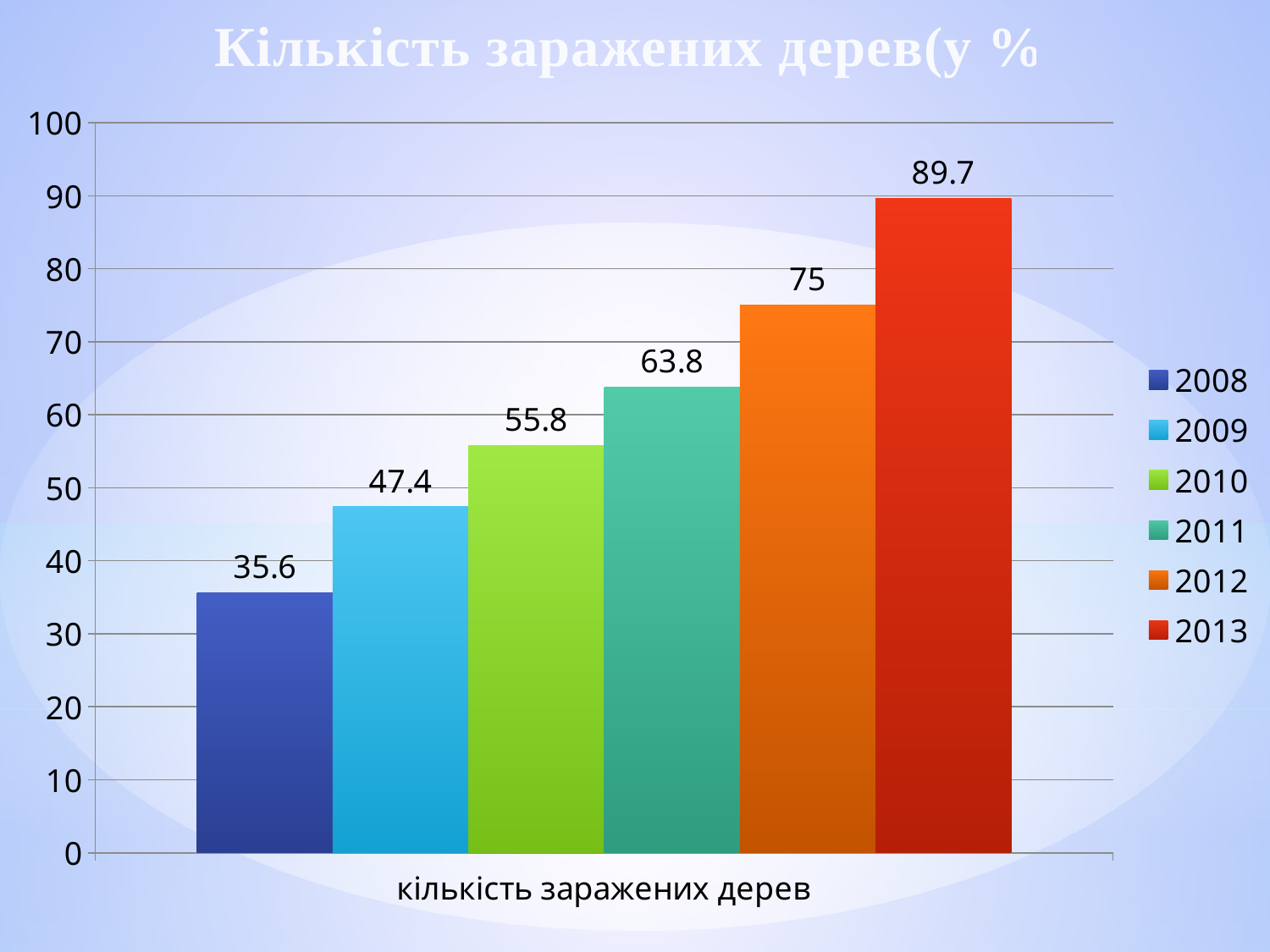
How many series does the legend list? 6 Which is larger, the value for 2009 or the value for 2011? 2011 Is the value for 2010 greater or less than 50? greater What is the value for 2011? 63.8 Do the values rise or fall from 2008 to 2013? rise Which year has the highest value? 2013 What kind of chart is shown on the slide? bar chart What is the difference between the values for 2013 and 2012? 14.7 What is the difference between the values for 2010 and 2009? 8.4 What is the value for 2012? 75 Which year has the lowest value? 2008 What is the value for 2008? 35.6